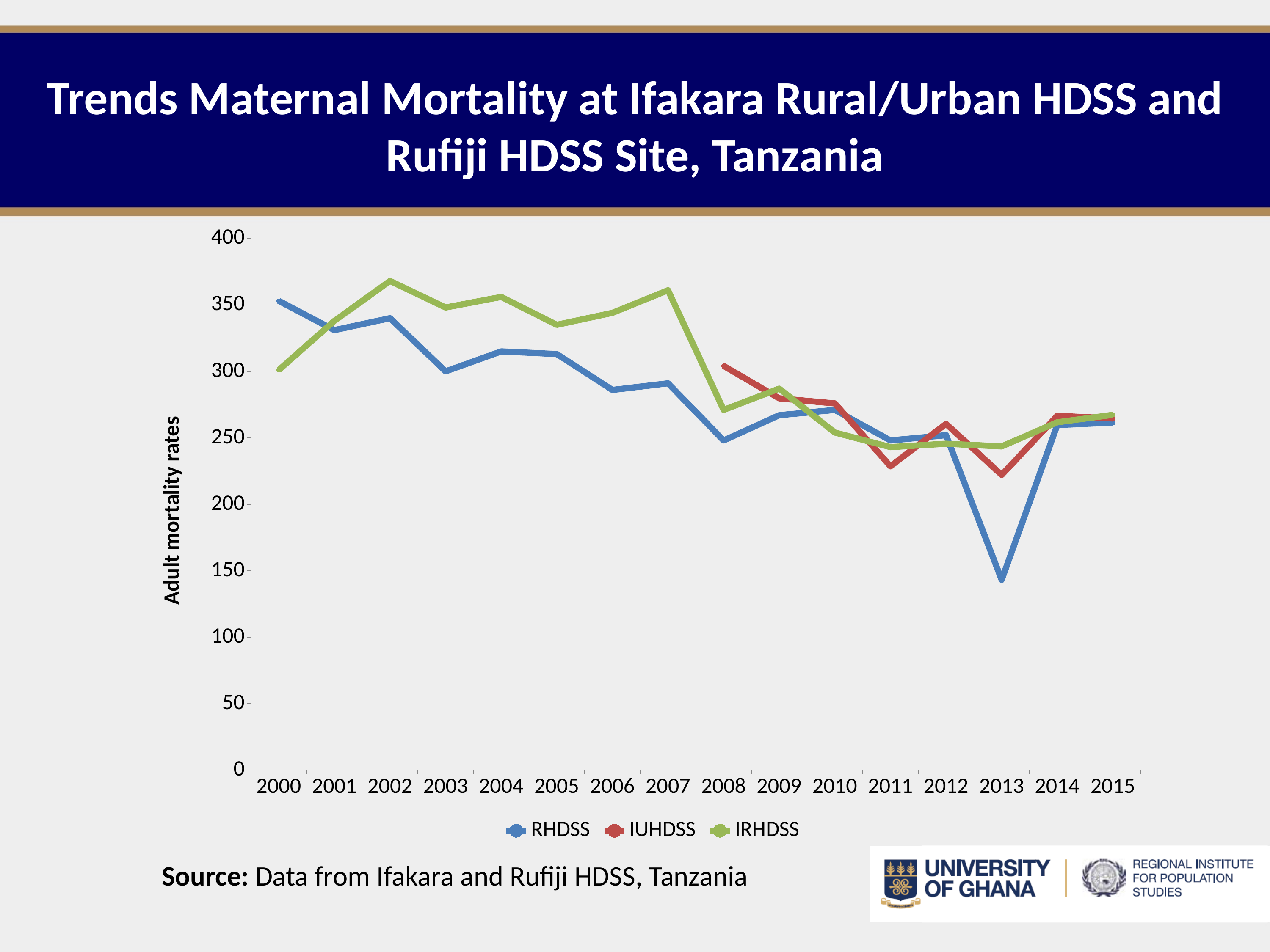
Is the value for RHDSS in 2013 greater or less than 150? less Is the value for IUHDSS in 2011 greater or less than 250? less In 2000, which is larger, RHDSS or IRHDSS? RHDSS Is the value for RHDSS in 2000 greater or less than 300? greater In which year does the RHDSS series reach its lowest value? 2013 How many series does the legend list? 3 Does the RHDSS series overall rise or fall from 2000 to 2015? Fall How many years are shown on the x axis? 16 Which series has the highest value in 2002? IRHDSS In 2013, which is larger, RHDSS or IUHDSS? IUHDSS What kind of chart is shown on the slide? Line chart